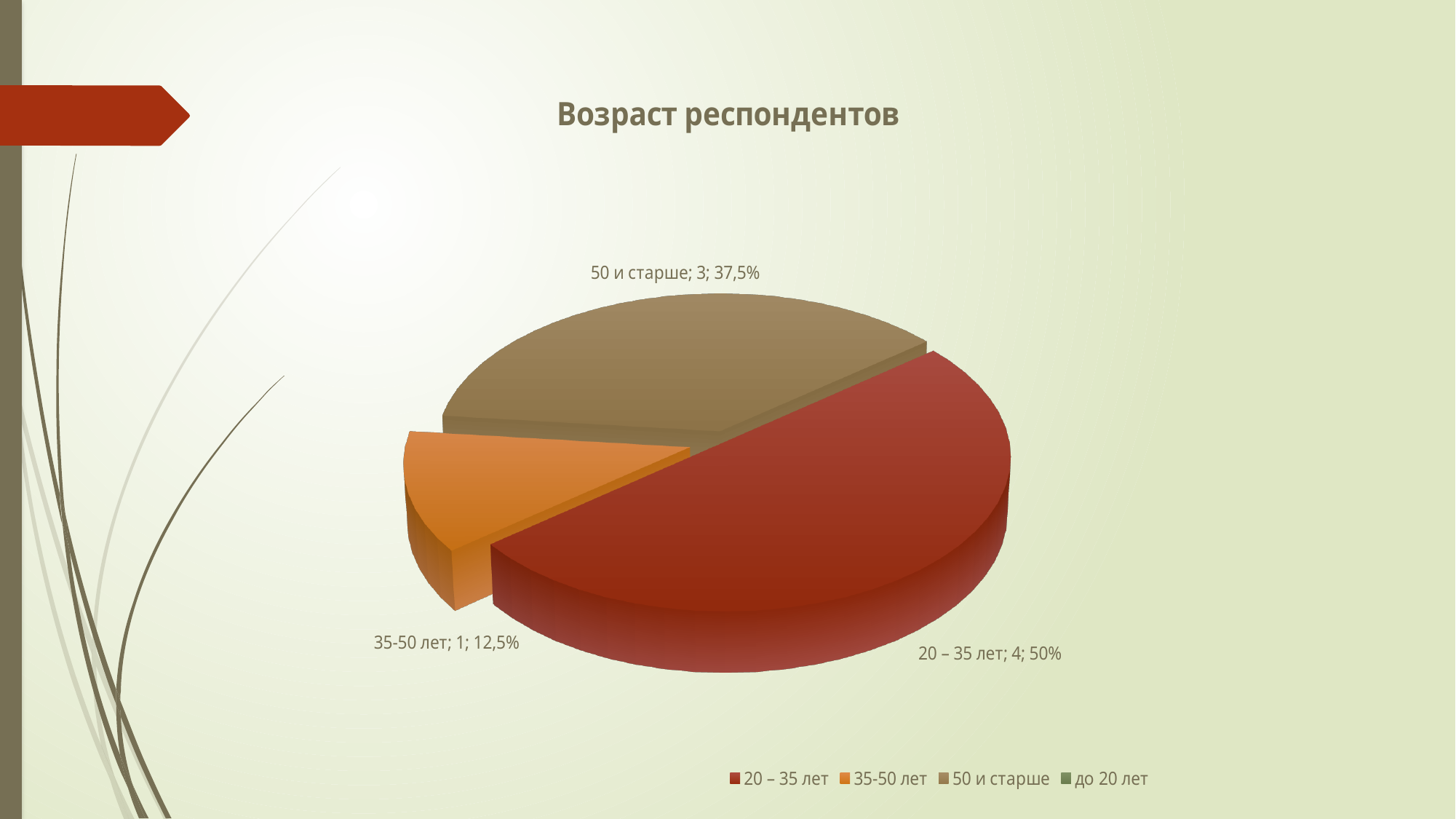
What share of the pie does the "20 – 35 лет" slice represent? 50% Which of the visible slices is the smallest? 35-50 лет How many entries does the chart legend list? 4 Which age category has the largest slice of the pie? 20 – 35 лет What kind of chart is shown on the slide? pie chart What share of the pie does the "35-50 лет" slice represent? 12,5% Which is larger: the share for "50 и старше" or the share for "35-50 лет"? 50 и старше What is the difference in respondent count between "20 – 35 лет" and "35-50 лет"? 3 What share of the pie does the "50 и старше" slice represent? 37,5% What is the title of the chart? Возраст респондентов How many respondents are in the "35-50 лет" category? 1 How many respondents are in the "50 и старше" category? 3